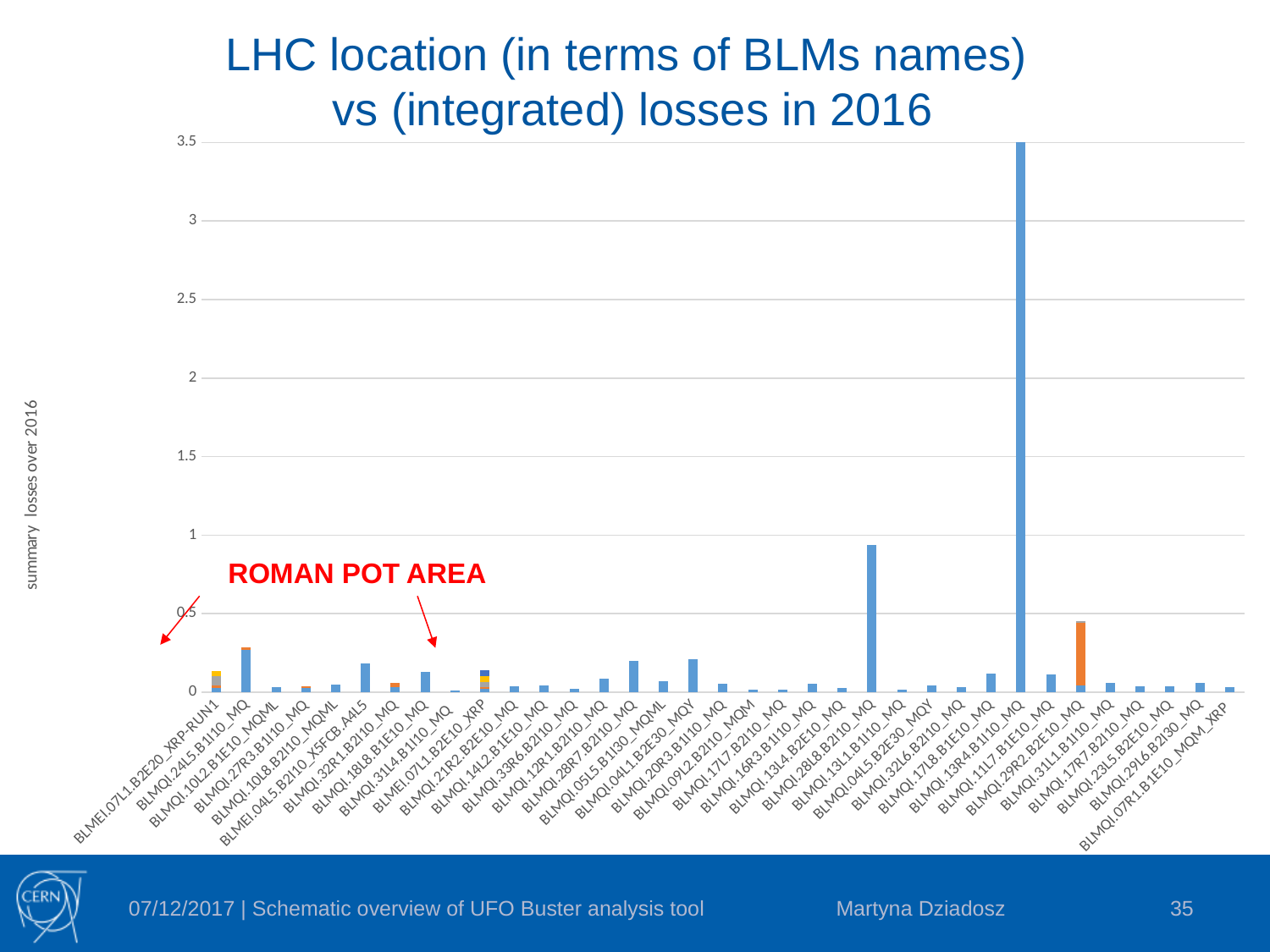
What kind of chart is shown on the slide? bar chart Is the value for BLMQI.28L8.B2I10_MQ greater or less than 1? less Which has the larger value, BLMQI.28L8.B2I10_MQ or BLMQI.24L5.B1I10_MQ? BLMQI.28L8.B2I10_MQ What is the label on the vertical axis of the chart? summary losses over 2016 What is the title of the chart? LHC location (in terms of BLMs names) vs (integrated) losses in 2016 How many BLM locations (categories) are shown on the x axis of the chart? 35 Which BLM location has the highest integrated losses in the chart? BLMQI.13R4.B1I10_MQ Is the value for BLMQI.13R4.B1I10_MQ greater or less than 3? greater Is the value for BLMQI.28L8.B2I10_MQ greater or less than 0.5? greater Which has the larger value, BLMQI.13R4.B1I10_MQ or BLMQI.28L8.B2I10_MQ? BLMQI.13R4.B1I10_MQ What is the highest tick value shown on the vertical axis of the chart? 3.5